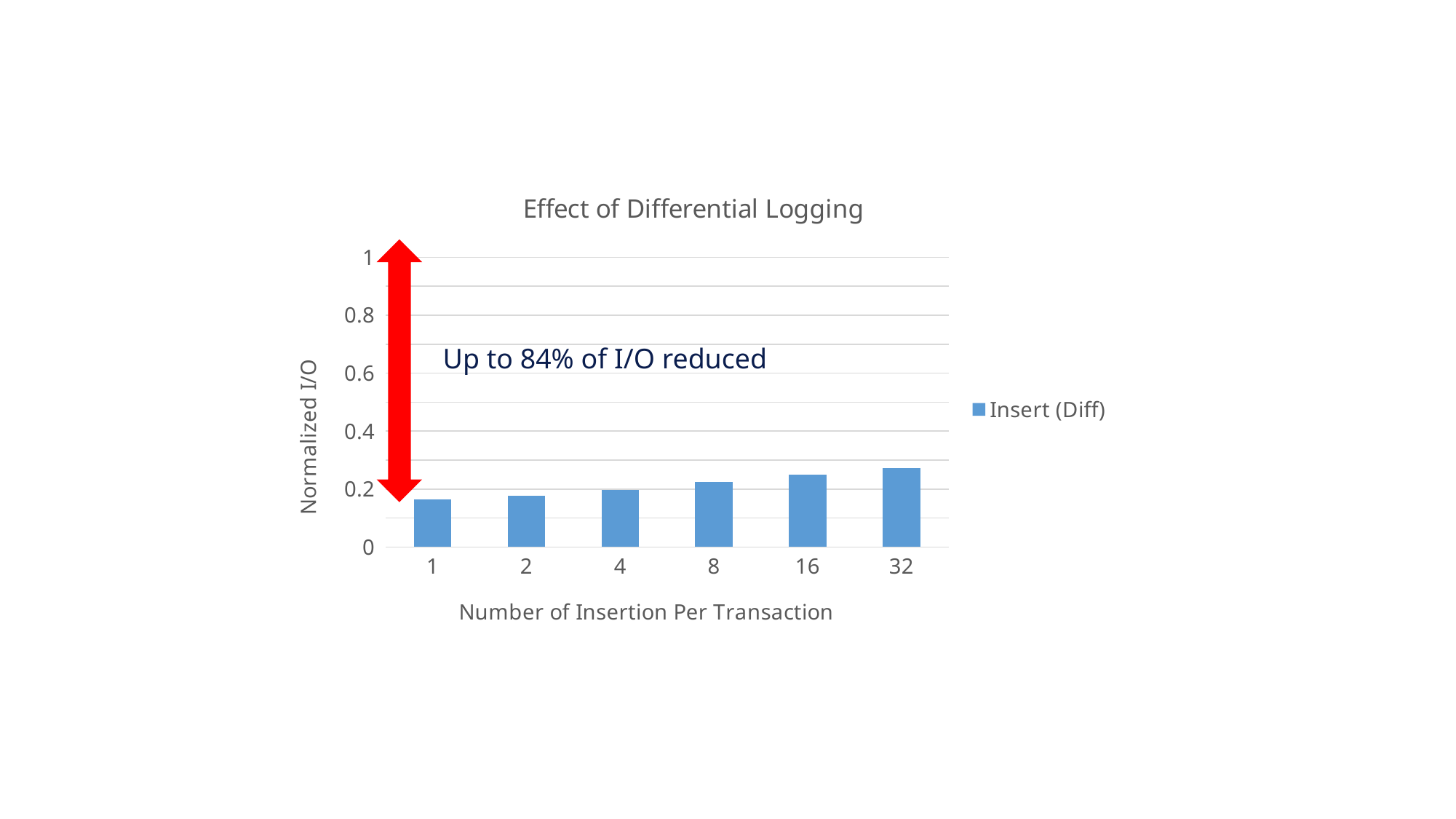
Do the normalized I/O values rise or fall as the number of insertions per transaction increases? rise Is the normalized I/O for 16 insertions per transaction greater or less than 0.4? less Is the normalized I/O for 32 insertions per transaction greater or less than 0.2? greater How many series does the legend list? 1 Which number of insertions per transaction has the lowest normalized I/O? 1 What kind of chart is shown on the slide? bar chart What is the title of the chart? Effect of Differential Logging Which number of insertions per transaction has the highest normalized I/O? 32 How many categories are shown on the x axis? 6 Is the normalized I/O for 1 insertion per transaction greater or less than 0.2? less What is the name of the series shown in the legend? Insert (Diff) Which has a larger normalized I/O: 32 insertions per transaction or 1 insertion per transaction? 32